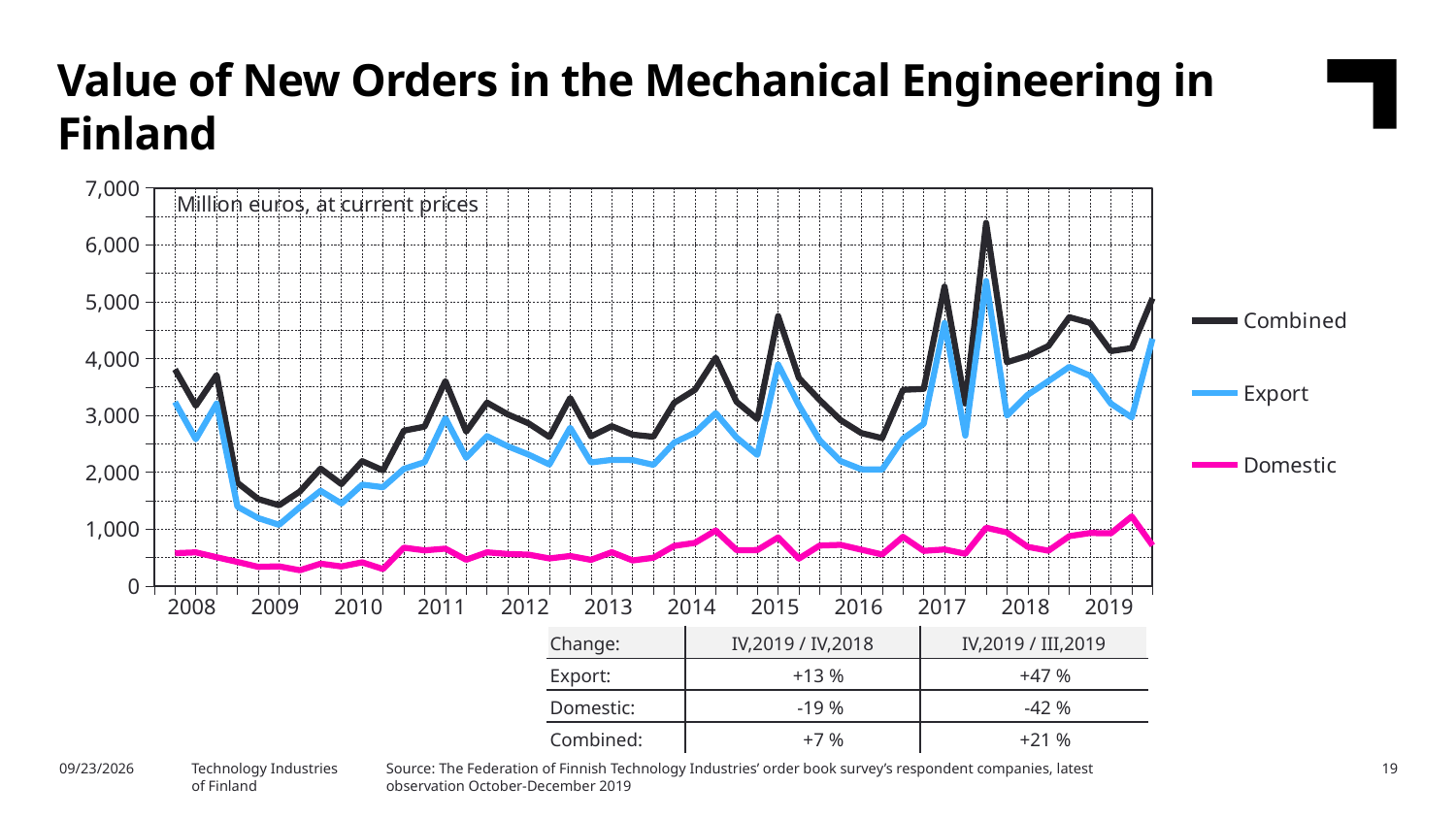
Is the peak value of the Export series in 2017 greater or less than 5,000? greater What unit note is printed inside the chart area? Million euros, at current prices Is the value of the Domestic series at the start of 2008 greater or less than 1,000? less Which series has the lowest values throughout the chart? Domestic What kind of chart is shown on the slide? Line chart Is the lowest value of the Combined series in 2009 greater or less than 2,000? less Which series has the highest values throughout the chart? Combined Does the Combined series rise or fall from the start of 2008 to 2009? Fall In 2015, which series is larger, Export or Domestic? Export How many series does the chart legend list? 3 How many years are labelled on the x axis? 12